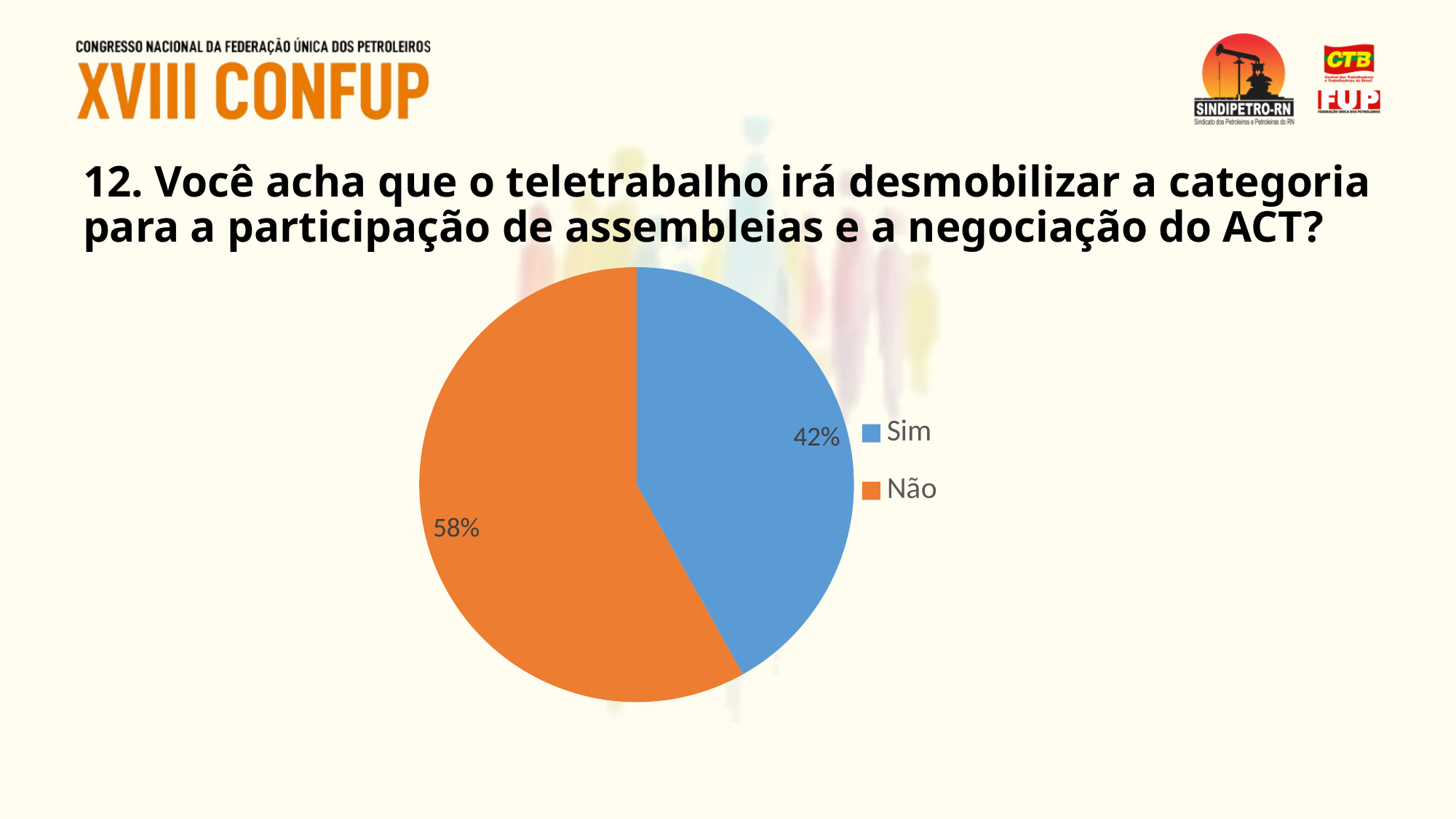
What colour is the "Sim" slice? Blue What is the difference in percentage points between "Não" and "Sim"? 16 What colour is the "Não" slice? Orange What percentage of respondents answered "Sim"? 42% Which is larger, the share for "Sim" or the share for "Não"? Não What kind of chart is shown on the slide? Pie chart Which response has the largest share of the pie? Não How many slices does the pie chart have? 2 How many entries does the legend list? 2 What share of the pie does the "Sim" slice represent? 42% What percentage of respondents answered "Não"? 58% Which response has the smallest share of the pie? Sim